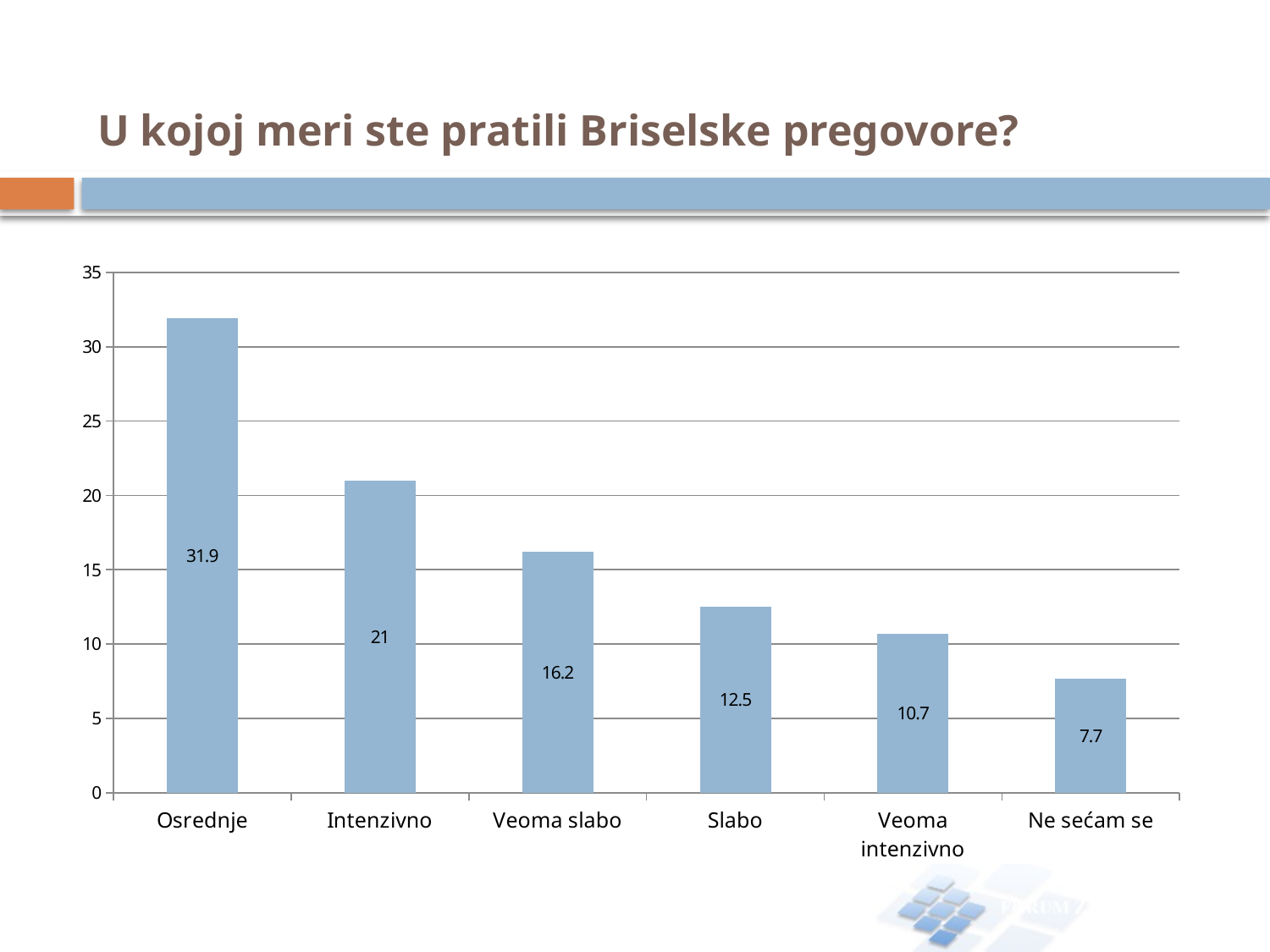
Which category has the highest value? Osrednje What is the value for Veoma slabo? 16.2 How many categories are shown on the x axis? 6 What is the value for Osrednje? 31.9 What is the value for Intenzivno? 21 What is the difference between the values for Osrednje and Intenzivno? 10.9 Which is larger, the value for Veoma slabo or the value for Slabo? Veoma slabo What is the value for Ne sećam se? 7.7 Is the value for Veoma intenzivno greater or less than 15? less What kind of chart is shown on the slide? bar chart Which category has the lowest value? Ne sećam se What is the difference between the values for Slabo and Veoma intenzivno? 1.8